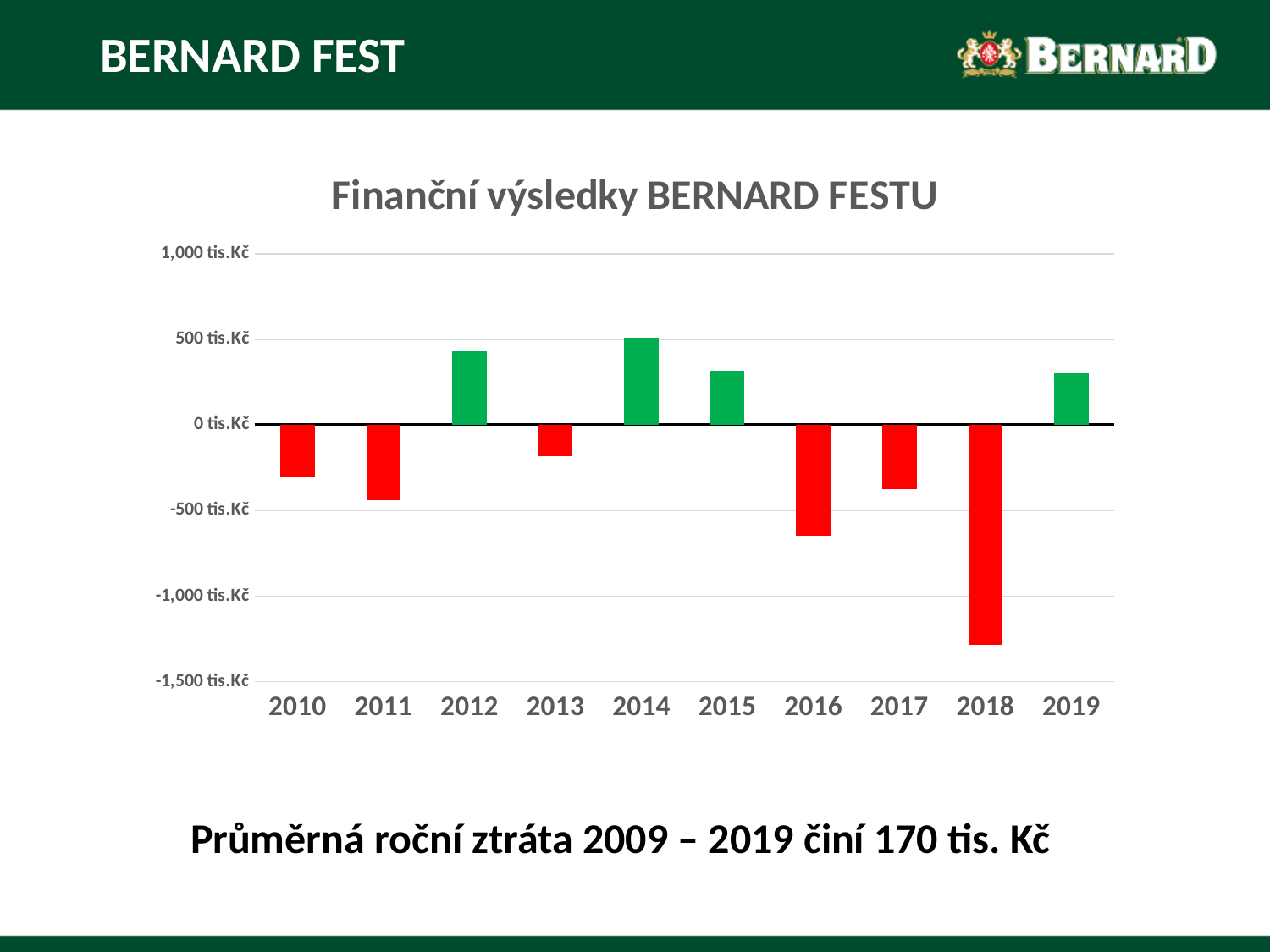
Is the value for 2018 greater or less than -1,000 tis.Kč? less Which year has the larger value, 2012 or 2015? 2012 Which year has the highest value in the chart? 2014 Which year has the larger value, 2016 or 2017? 2017 What is the title of the chart? Finanční výsledky BERNARD FESTU What colour are the bars with negative values in the chart? red Is the value for 2010 greater or less than -500 tis.Kč? greater How many years are shown on the x axis of the chart? 10 Which year has the lowest value in the chart? 2018 Is the value for 2016 greater or less than -500 tis.Kč? less What kind of chart is shown on the slide? bar chart